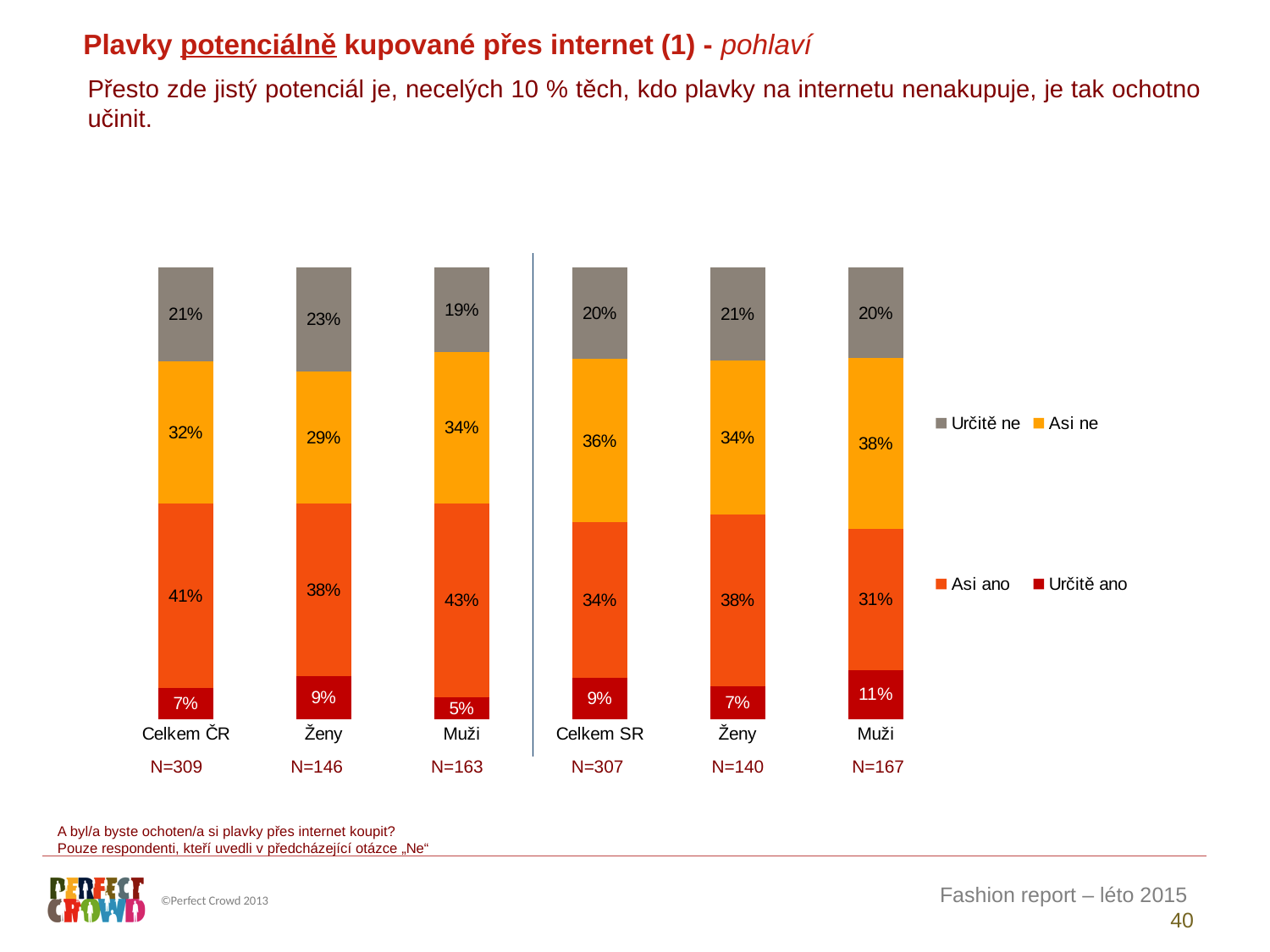
Which is larger: the "Asi ne" value for Ženy in the ČR group or for Ženy in the SR group? Ženy in the SR group (34%) What kind of chart is shown on the slide? stacked bar chart How many bars (categories) are plotted in the chart? 6 Which category has the highest "Určitě ano" value? Muži (SR, N=167) What is the value of "Určitě ano" for Celkem ČR? 7% Which category has the lowest "Určitě ano" value? Muži (ČR, N=163) What is the value of "Asi ano" for Muži in the ČR group (N=163)? 43% What is the value of "Určitě ne" for Ženy in the SR group (N=140)? 21% What is the difference between the "Asi ano" values for Celkem ČR and Celkem SR? 7 percentage points What is the sample size (N) shown for Celkem SR? N=307 What is the value of "Asi ne" for Celkem SR? 36% How many series does the legend list? 4